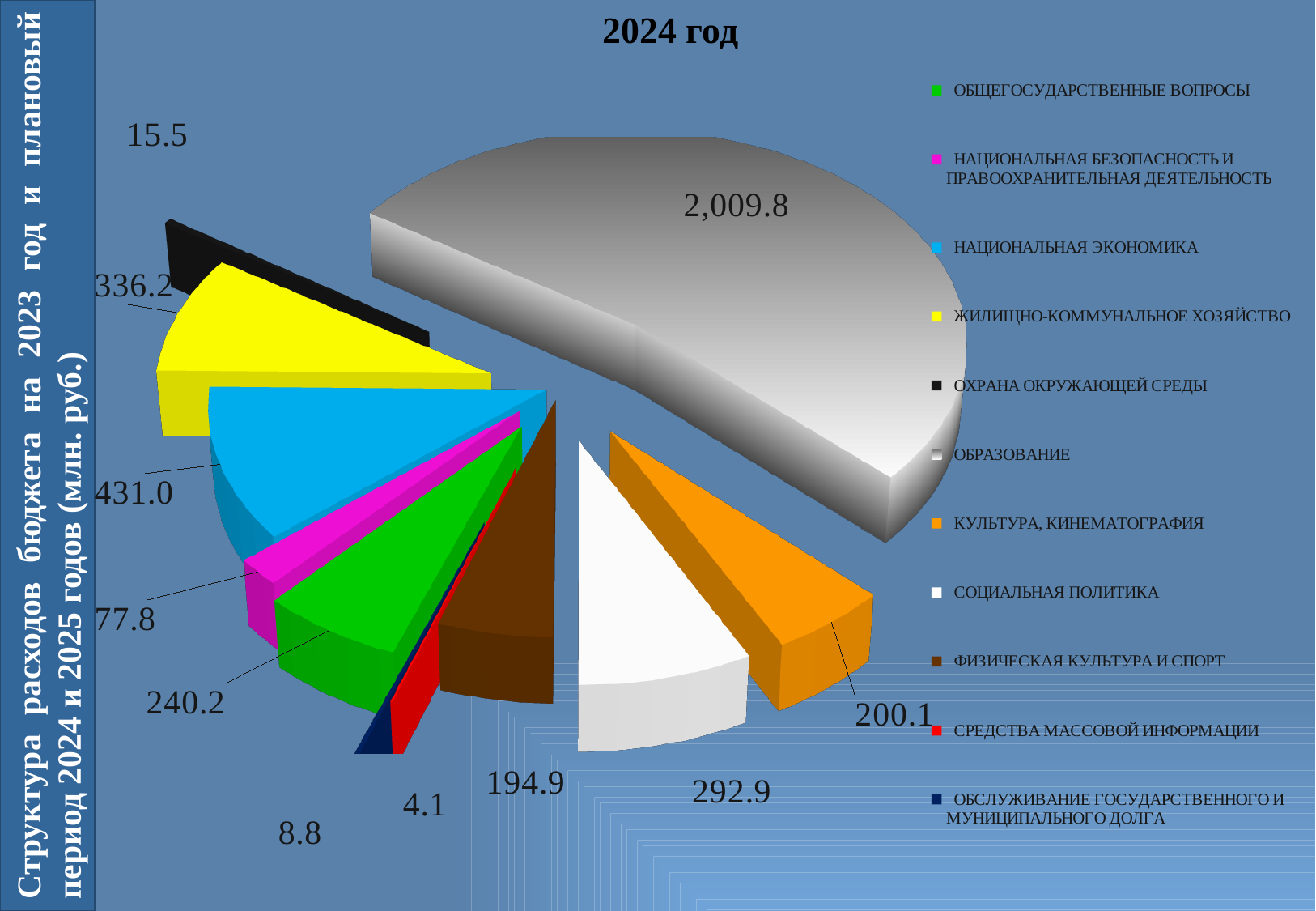
What is the value for ОБРАЗОВАНИЕ? 2,009.8 What kind of chart is shown on the slide? Pie chart What is the value for СОЦИАЛЬНАЯ ПОЛИТИКА? 292.9 What is the value for КУЛЬТУРА, КИНЕМАТОГРАФИЯ? 200.1 Which category has the largest slice of the pie? ОБРАЗОВАНИЕ Which is larger, the value for ОБЩЕГОСУДАРСТВЕННЫЕ ВОПРОСЫ or the value for ФИЗИЧЕСКАЯ КУЛЬТУРА И СПОРТ? ОБЩЕГОСУДАРСТВЕННЫЕ ВОПРОСЫ What is the title of the chart? 2024 год What colour is the slice for ОХРАНА ОКРУЖАЮЩЕЙ СРЕДЫ? Black What is the difference between the values for НАЦИОНАЛЬНАЯ ЭКОНОМИКА and ЖИЛИЩНО-КОММУНАЛЬНОЕ ХОЗЯЙСТВО? 94.8 How many categories does the legend of the pie chart list? 11 What is the value for ЖИЛИЩНО-КОММУНАЛЬНОЕ ХОЗЯЙСТВО? 336.2 What is the value for НАЦИОНАЛЬНАЯ ЭКОНОМИКА? 431.0